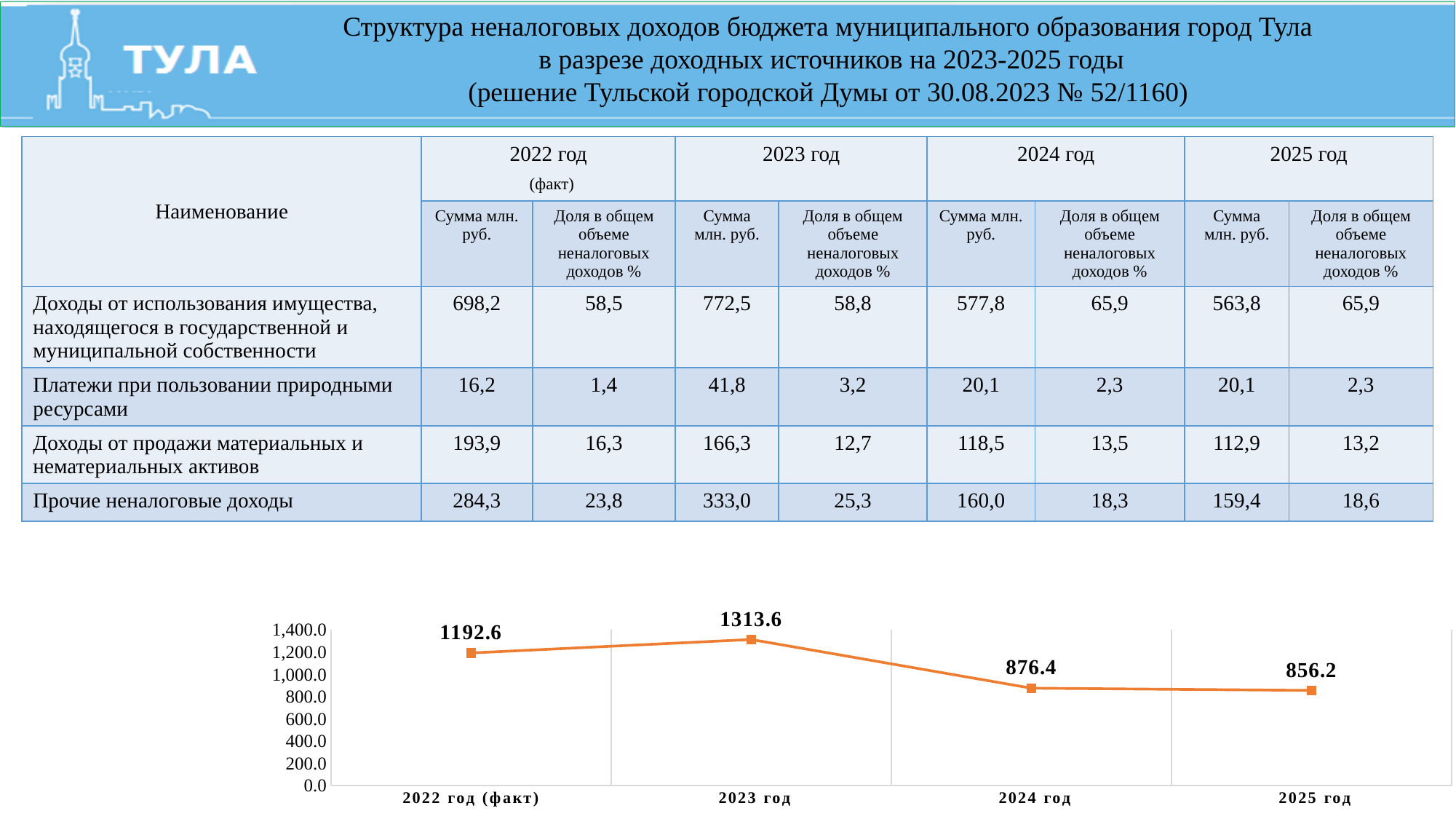
In the line chart, do the values rise or fall from 2023 год to 2025 год? fall How many data points are plotted in the line chart? 4 In the line chart, which year has the lowest value? 2025 год In the line chart, what is the value for 2024 год? 876.4 In the line chart, which year has the highest value? 2023 год What type of chart is shown at the bottom of the slide? line chart In the line chart, what is the difference between the values for 2023 год and 2024 год? 437.2 In the line chart, what is the value for 2025 год? 856.2 In the line chart, what is the value for 2023 год? 1313.6 In the line chart, is the value for 2024 год greater or less than 1,000.0? less In the line chart, which is larger: the value for 2022 год (факт) or the value for 2025 год? 2022 год (факт) In the line chart, what is the value for 2022 год (факт)? 1192.6